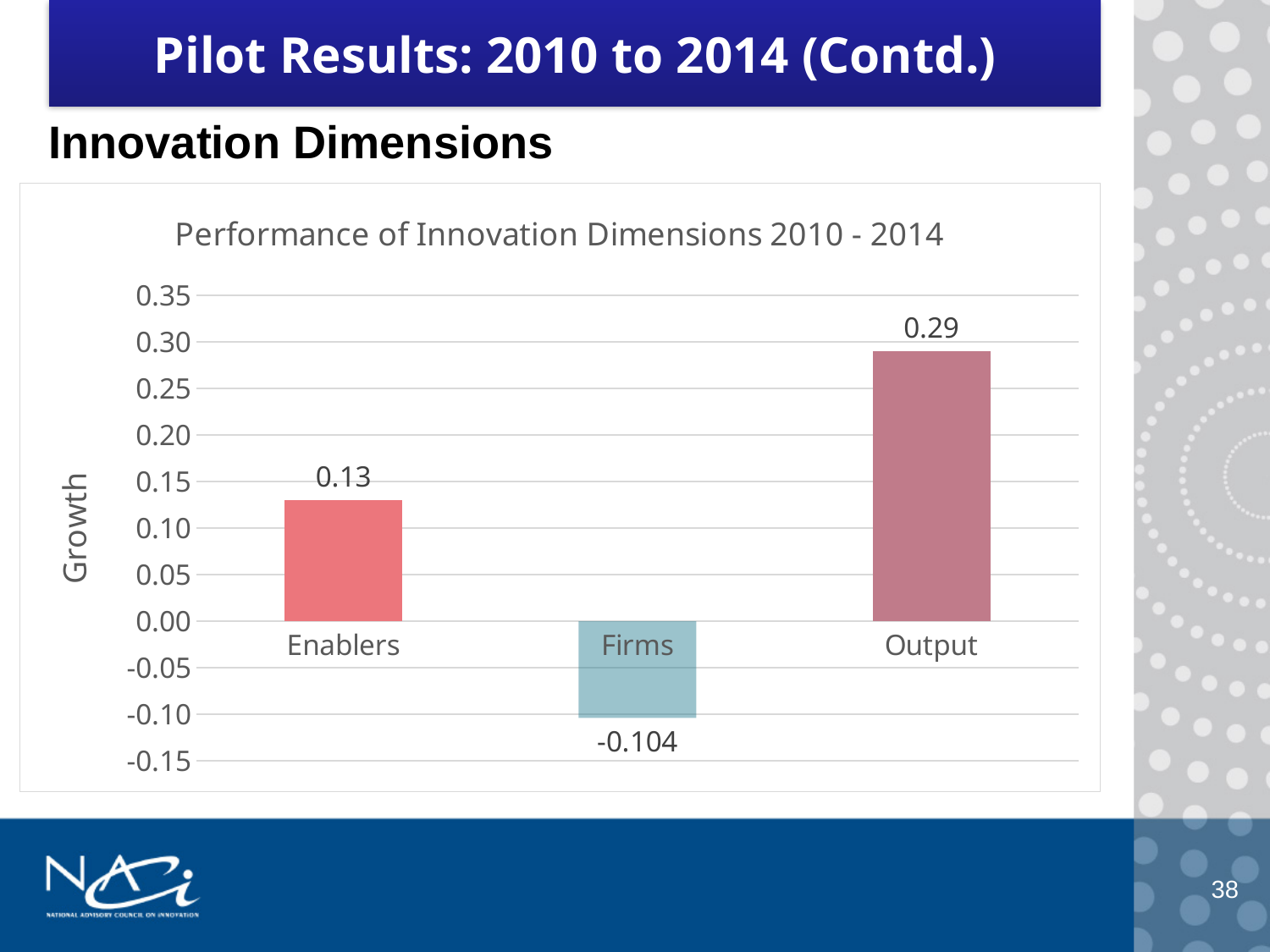
What is the difference between the growth values for Output and Enablers? 0.16 What is the growth value for Firms? -0.104 Is the growth value for Output greater or less than 0.25? greater How many innovation dimensions are shown in the chart? 3 What kind of chart is shown on the slide? bar chart What is the label on the vertical axis of the chart? Growth Which has a larger growth value, Enablers or Firms? Enablers What is the title of the chart? Performance of Innovation Dimensions 2010 - 2014 What is the growth value for Enablers? 0.13 What is the growth value for Output? 0.29 Which innovation dimension has the highest growth? Output Which innovation dimension has the lowest growth? Firms